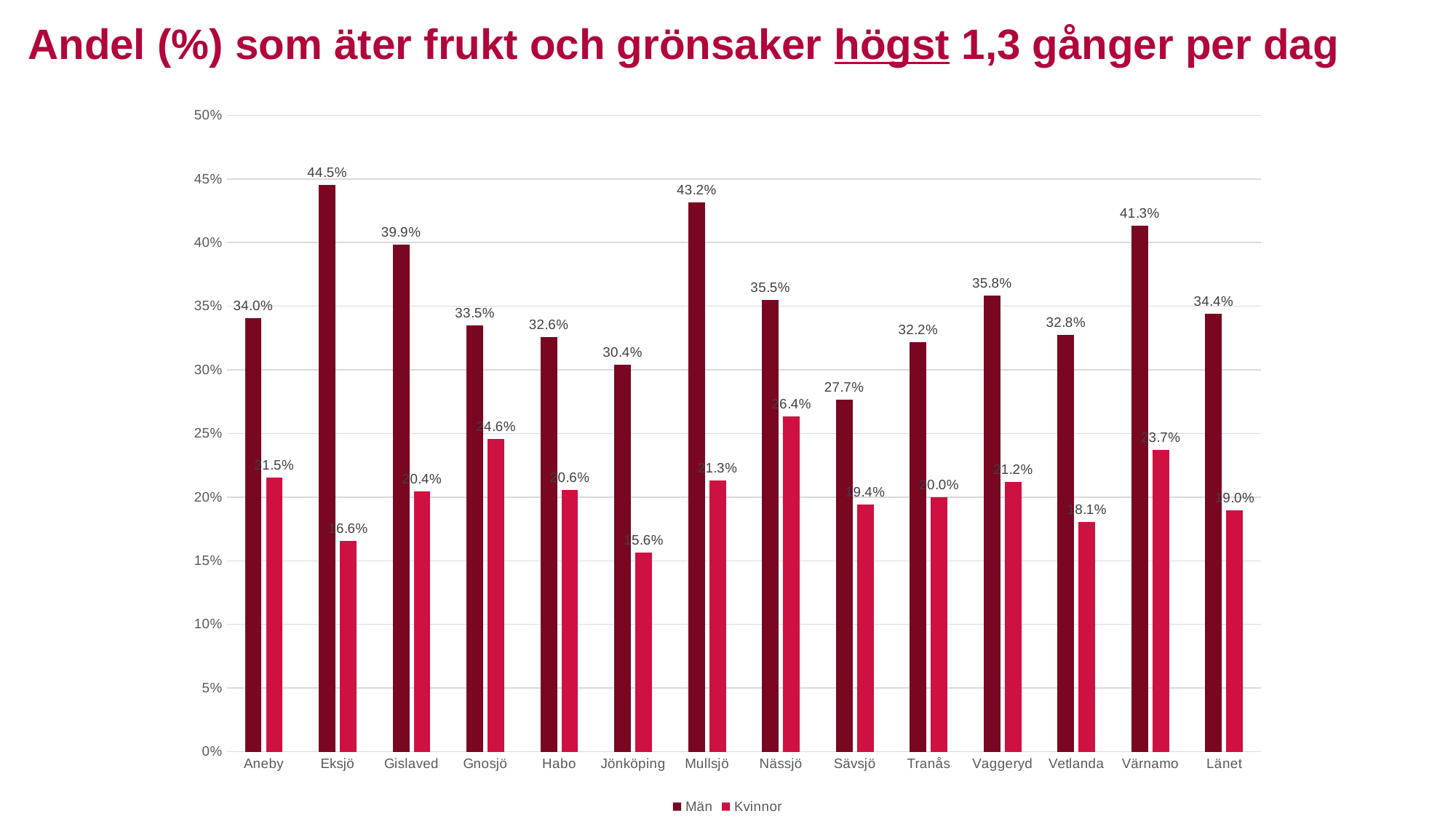
What is the difference between Män and Kvinnor in Mullsjö? 21.9% Which category has the highest value for Män? Eksjö Which category has the highest value for Kvinnor? Nässjö Which category has the lowest value for Kvinnor? Jönköping What is the value for Kvinnor in Länet? 19.0% Is the value for Män in Sävsjö greater or less than 30%? less How many series does the legend list? 2 How many categories are shown on the x axis? 14 Which is larger, the Män value for Värnamo or the Män value for Gislaved? Värnamo What is the value for Män in Eksjö? 44.5% What is the value for Kvinnor in Jönköping? 15.6% What kind of chart is shown on the slide? bar chart